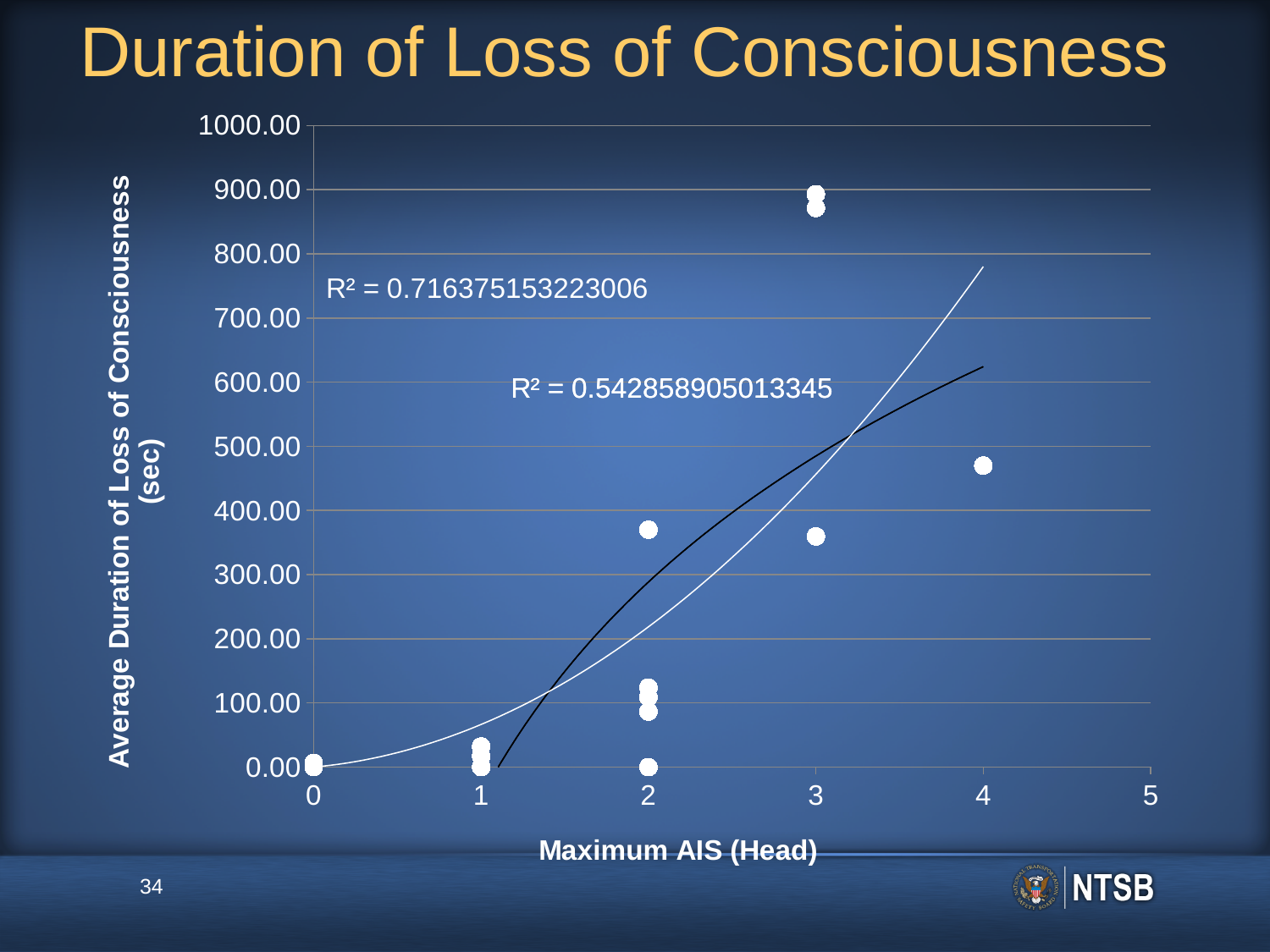
What kind of chart is shown on the slide? scatter plot Is the data point at Maximum AIS (Head) 4 greater or less than 500? less What is the label of the x axis? Maximum AIS (Head) Is the data point at Maximum AIS (Head) 4 greater or less than 400? greater Which is larger: the data point at Maximum AIS (Head) 4 or the highest data point at Maximum AIS (Head) 2? Maximum AIS (Head) 4 Is the highest data point at Maximum AIS (Head) 3 greater or less than 800? greater What is the higher R² value printed on the chart? R² = 0.716375153223006 What is the title of the chart? Duration of Loss of Consciousness At which Maximum AIS (Head) value do the highest data points appear? 3 Do the fitted trend lines rise or fall as Maximum AIS (Head) increases? rise What is the lower R² value printed on the chart? R² = 0.542858905013345